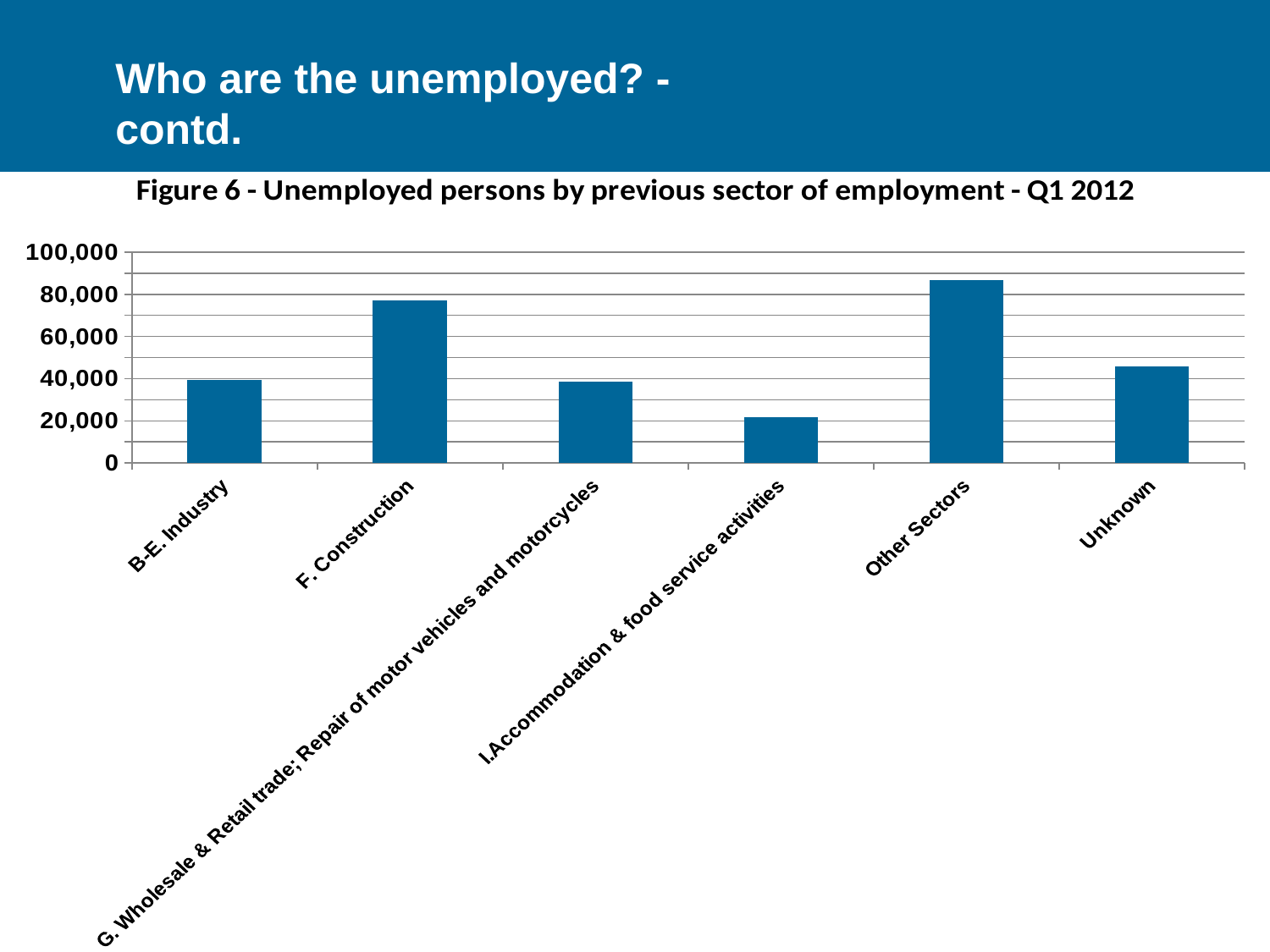
Is the value for Other Sectors greater or less than 80,000? greater How many sectors (bars) are shown in the chart? 6 Is the value for F. Construction greater or less than 60,000? greater What kind of chart is shown on the slide? Bar chart Is the value for B-E. Industry greater or less than 60,000? less Which sector has the lowest number of unemployed persons? I.Accommodation & food service activities Which has more unemployed persons, F. Construction or Unknown? F. Construction Which has more unemployed persons, Other Sectors or B-E. Industry? Other Sectors What is the maximum value shown on the vertical axis? 100,000 Which sector has the highest number of unemployed persons? Other Sectors What is the title of the chart? Figure 6 - Unemployed persons by previous sector of employment - Q1 2012